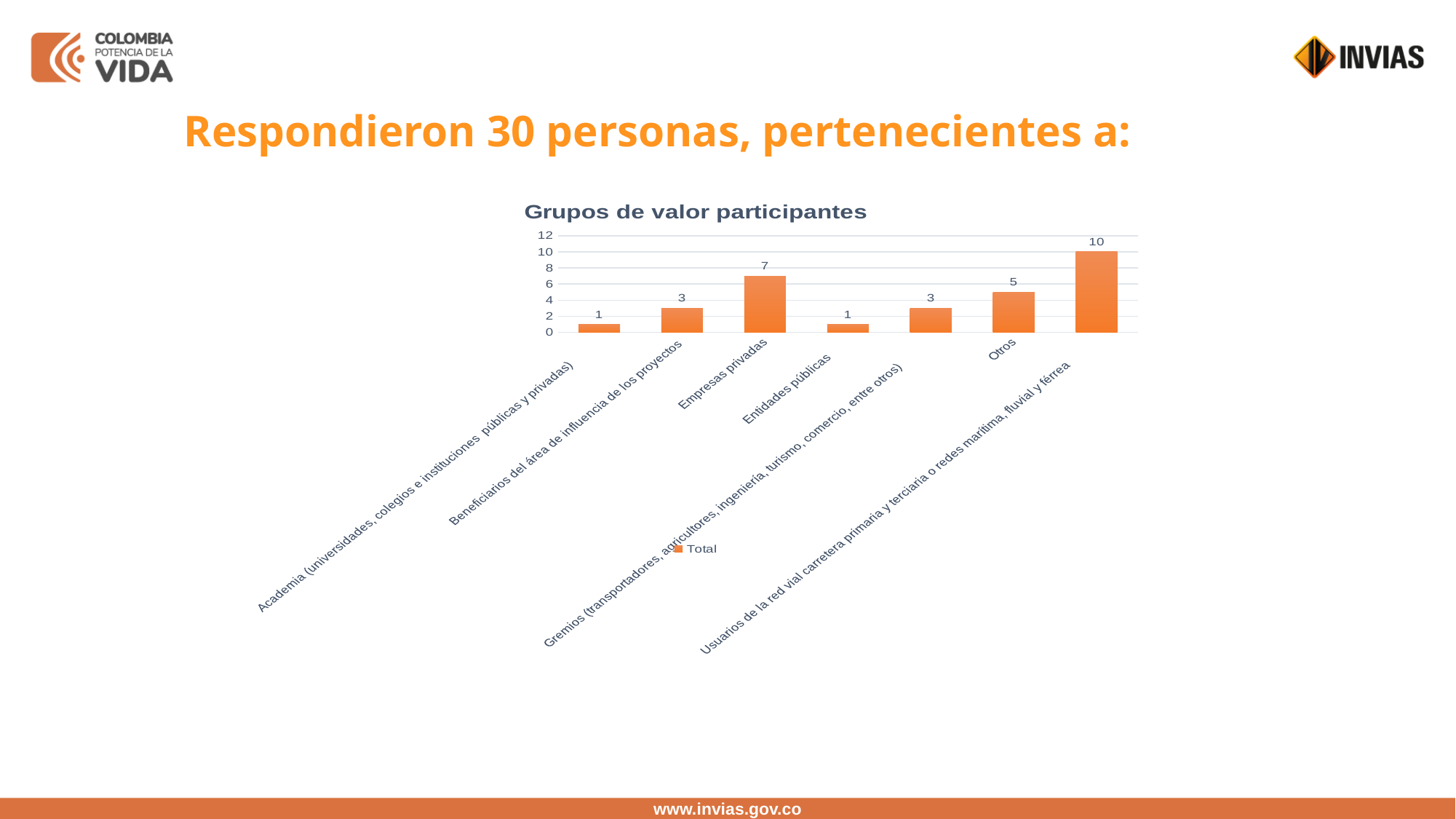
What kind of chart is shown? Bar chart What is the value for Entidades públicas? 1 How many categories are shown on the x axis? 7 What is the name of the series in the legend? Total What is the value for Empresas privadas? 7 What is the value for Otros? 5 What is the title of the chart? Grupos de valor participantes What is the value for Beneficiarios del área de influencia de los proyectos? 3 Which is larger, the value for Otros or the value for Gremios (transportadores, agricultores, ingeniería, turismo, comercio, entre otros)? Otros What is the difference between the value for Usuarios de la red vial carretera primaria y terciaria o redes marítima, fluvial y férrea and the value for Empresas privadas? 3 Which category has the highest value? Usuarios de la red vial carretera primaria y terciaria o redes marítima, fluvial y férrea How many series does the legend list? 1